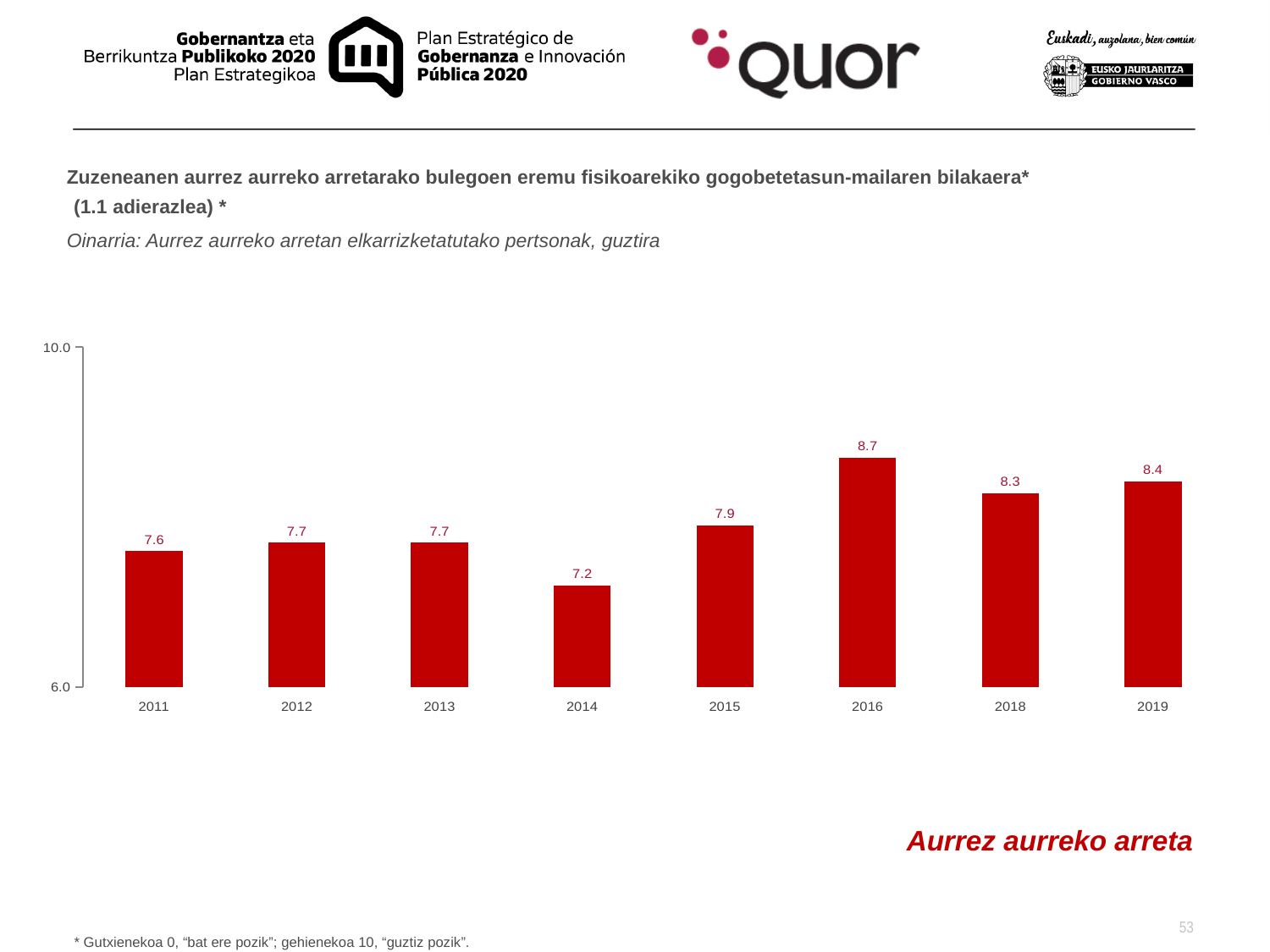
What is the value for 2019? 8.4 What kind of chart is shown on the slide? bar chart Which year has the lowest value? 2014 What is the difference between the values for 2019 and 2011? 0.8 What is the difference between the values for 2016 and 2014? 1.5 What is the value for 2011? 7.6 Which year has the highest value? 2016 Which is larger, the value for 2018 or the value for 2019? 2019 Do the values rise or fall from 2014 to 2016? rise What is the value for 2014? 7.2 How many years are shown on the x axis? 8 What is the value for 2016? 8.7